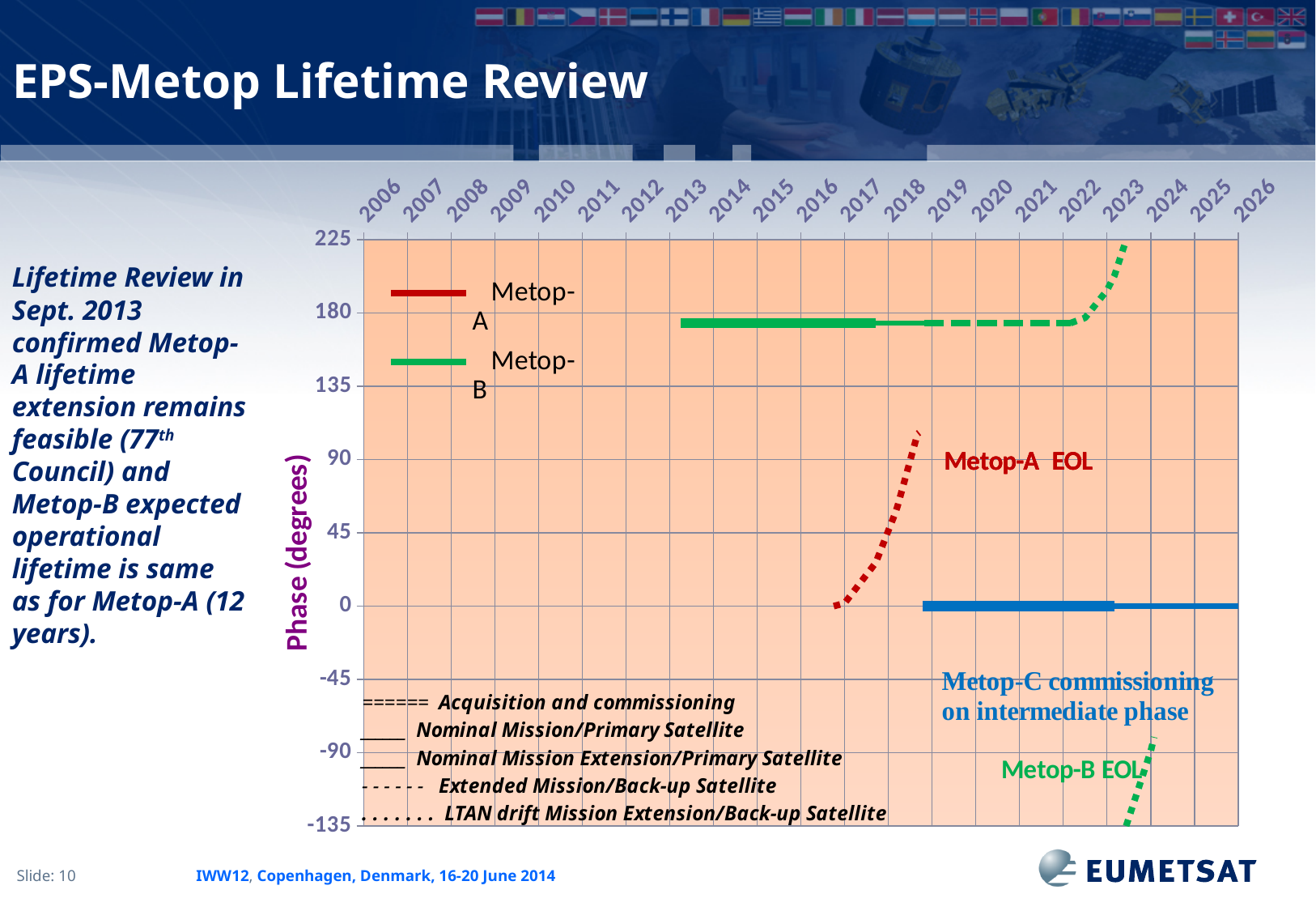
How many series does the chart legend list? 2 Is the value for Metop-B in 2015 greater or less than 135? greater What is the label of the vertical axis? Phase (degrees) What kind of chart is shown on the slide? line chart Is the value of the Metop-C line in 2024 greater or less than 45? less What colour is the Metop-B line in the legend? green Does the Metop-A line rise or fall between 2017 and 2018? rise In 2018, which series has the higher phase value, Metop-A or Metop-B? Metop-B Is the value for Metop-A in 2017 greater or less than 45? less How many year labels are shown along the x axis? 21